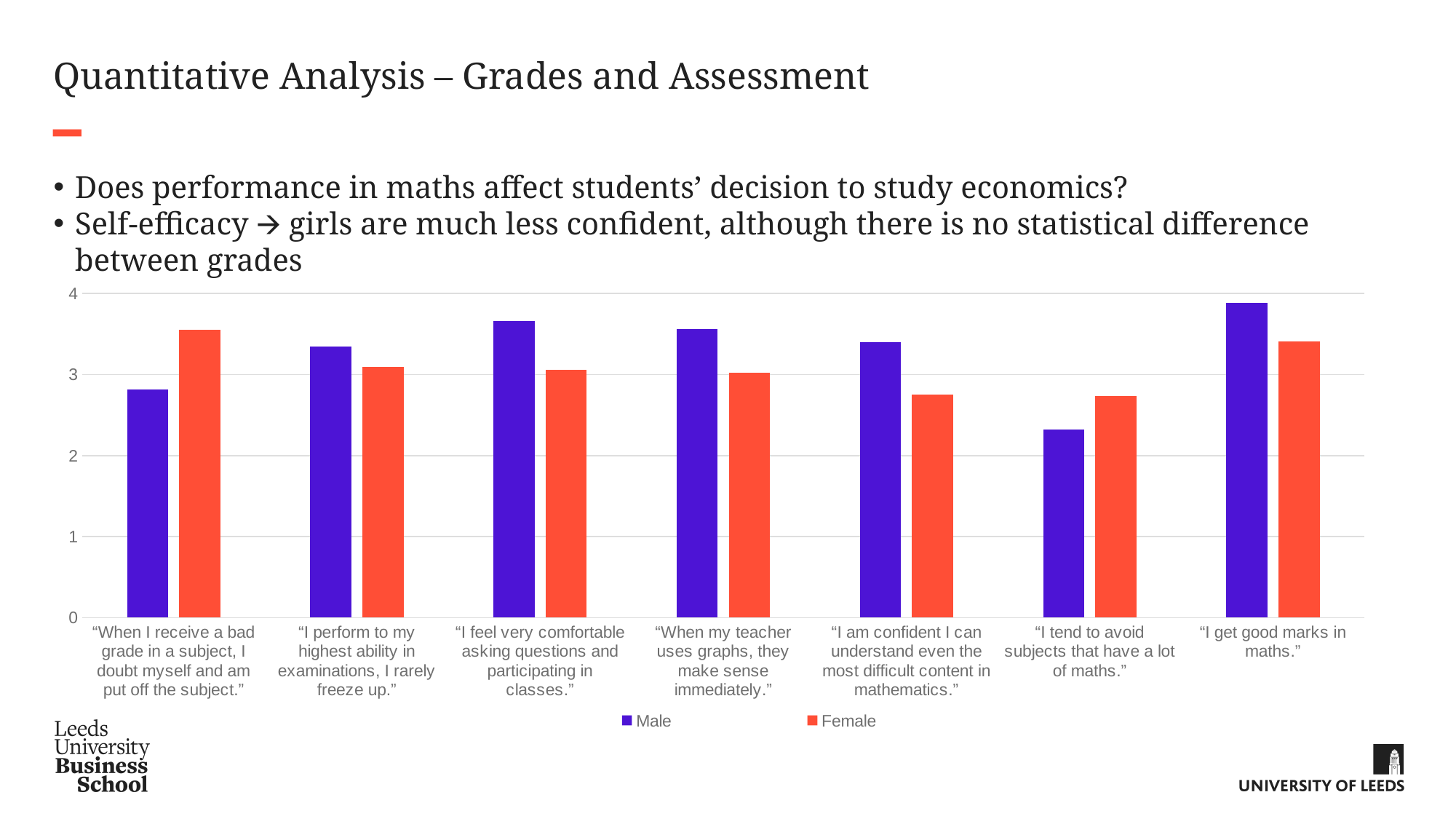
For the statement "When I receive a bad grade in a subject, I doubt myself and am put off the subject.", which is larger, the Male or the Female value? Female For which statement is the Male value highest? "I get good marks in maths." For the statement "I feel very comfortable asking questions and participating in classes.", which is larger, the Male or the Female value? Male For which statement is the Female value highest? "When I receive a bad grade in a subject, I doubt myself and am put off the subject." How many statement categories are plotted on the x axis? 7 For which statement is the Male value lowest? "I tend to avoid subjects that have a lot of maths." Is the Male value for "I tend to avoid subjects that have a lot of maths." greater or less than 3? less Which series is shown in purple according to the legend? Male Which series is shown in orange-red according to the legend? Female Is the Female value for "When I receive a bad grade in a subject, I doubt myself and am put off the subject." greater or less than 3? greater What kind of chart is shown on the slide? bar chart How many series does the legend list? 2